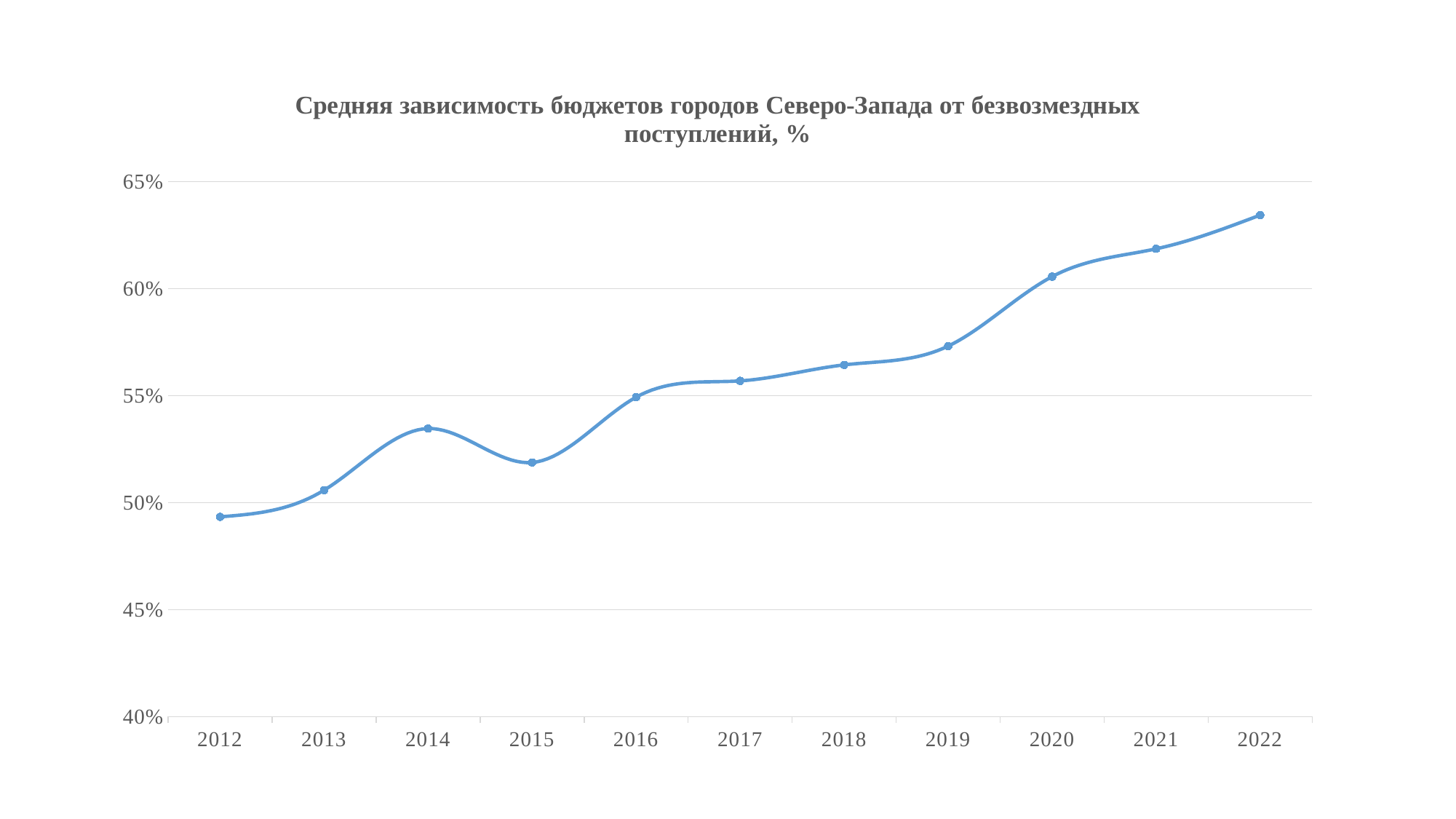
How many years are plotted on the x axis? 11 What kind of chart is shown on the slide? Line chart Is the value for 2022 greater or less than 60%? greater Which year has the larger value, 2014 or 2015? 2014 What is the title of the chart? Средняя зависимость бюджетов городов Северо-Запада от безвозмездных поступлений, % Which year has the lowest value? 2012 Is the value for 2012 greater or less than 50%? less Is the value for 2019 greater or less than 60%? less Which year has the highest value? 2022 Do the values generally rise or fall from 2012 to 2022? Rise